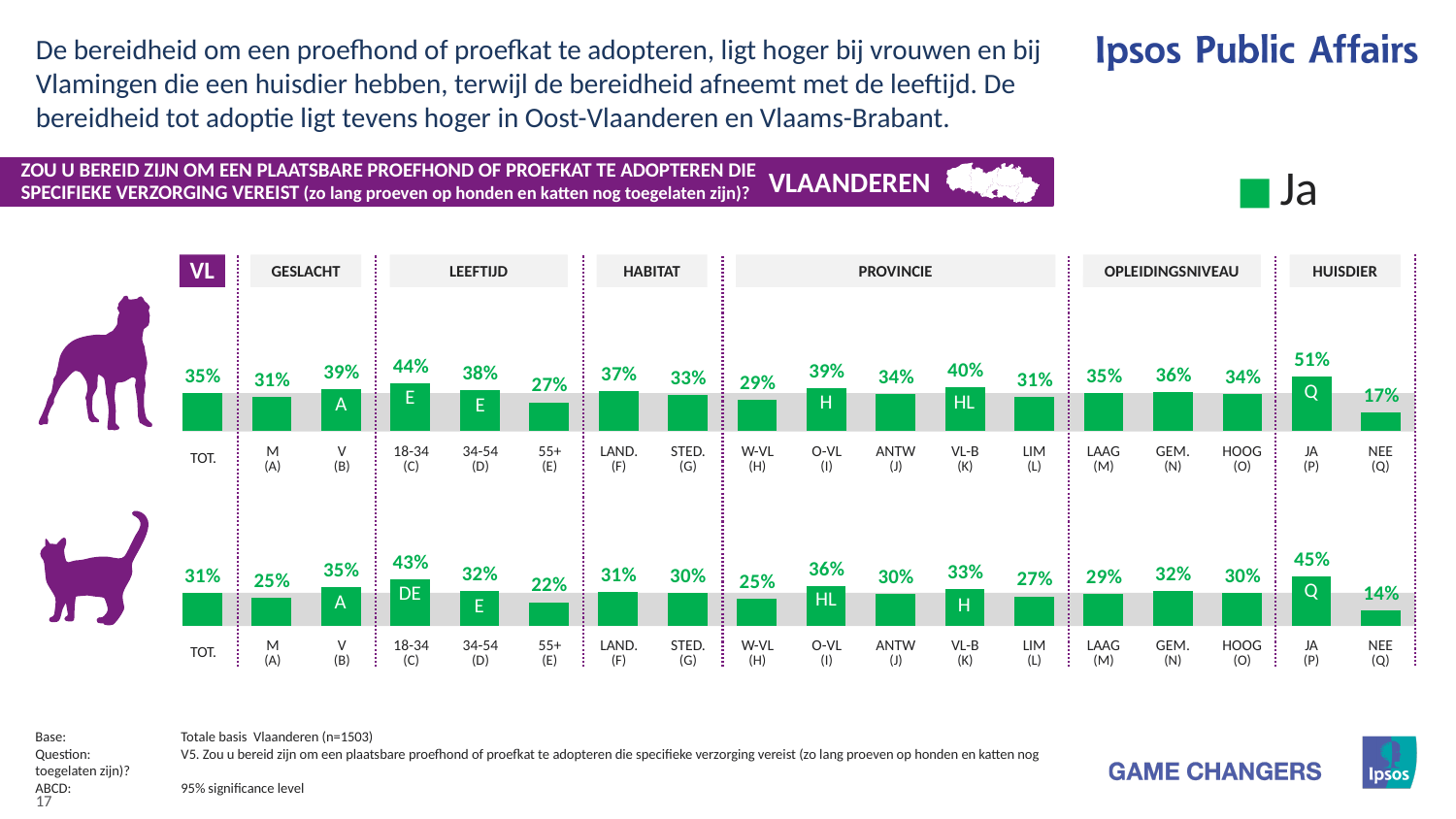
In the bottom (cat) chart, what is the value for the 18-34 age group? 43% In the top (dog) chart, what is the value for TOT.? 35% In the bottom (cat) chart, what is the value for 55+ (E)? 22% In the bottom (cat) chart, which is larger: the value for O-VL (I) or the value for W-VL (H)? O-VL (I) In the bottom (cat) chart, which category has the lowest value? NEE (Q) In the top (dog) chart, do the values rise or fall across the age groups from 18-34 to 55+? fall In the top (dog) chart, which category has the highest value? JA (P) In the top (dog) chart, what is the value for VL-B (K)? 40% How many categories (bars) are shown in the top (dog) chart? 18 What is the single legend entry shown on the slide? Ja What kind of chart is used on this slide? bar chart In the top (dog) chart, what is the difference between the values for V (B) and M (A)? 8%